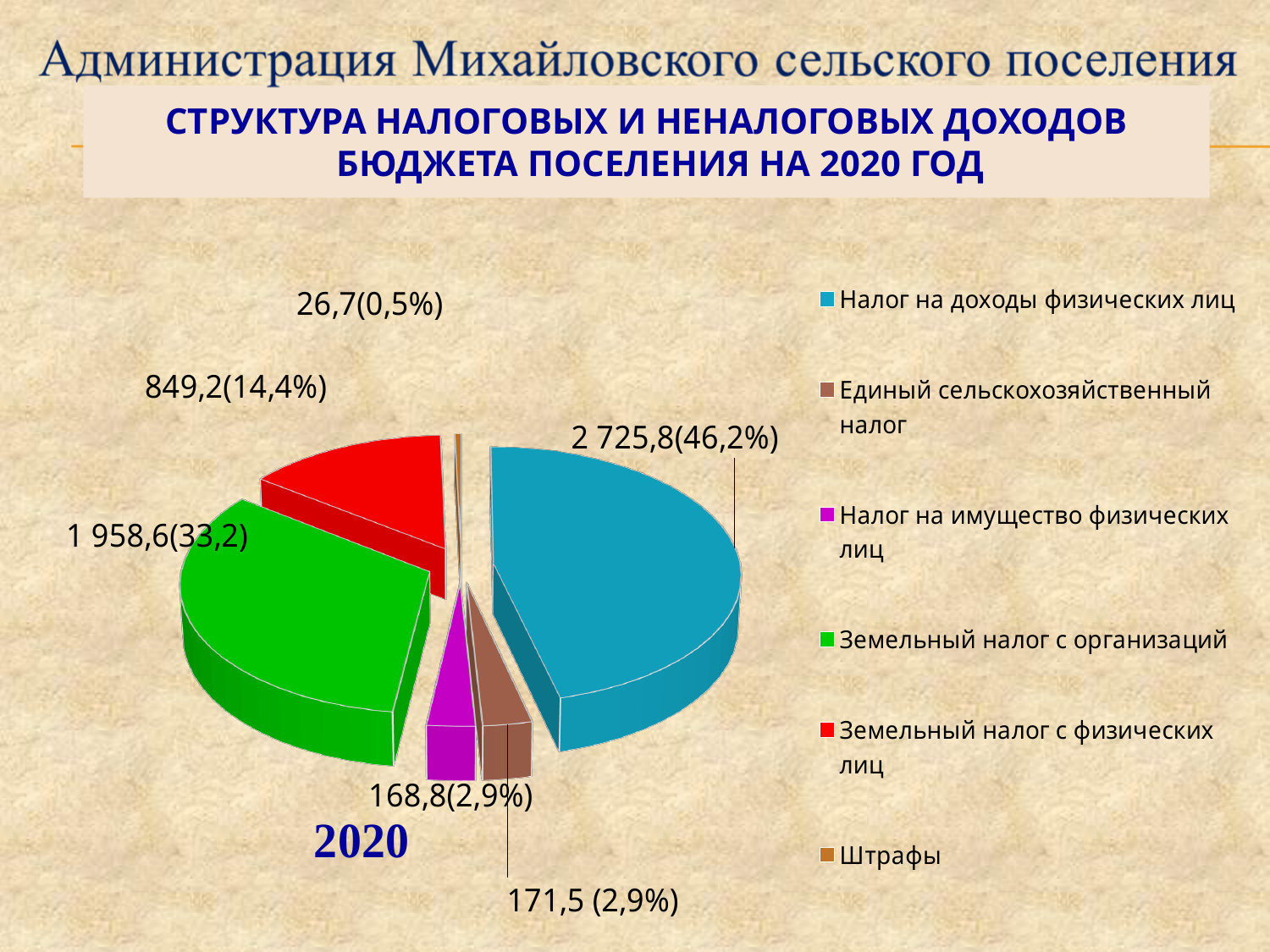
What share of the pie does Земельный налог с физических лиц have? 14,4% What value is shown for Земельный налог с организаций? 1 958,6(33,2) What value is shown for Налог на доходы физических лиц? 2 725,8(46,2%) Which category has the largest share of the pie? Налог на доходы физических лиц What value is shown for Земельный налог с физических лиц? 849,2(14,4%) What colour is the slice for Налог на доходы физических лиц? Blue What kind of chart is shown on the slide? Pie chart Which category has the smallest share of the pie? Штрафы How many categories does the legend of the pie chart list? 6 What value is shown for Налог на имущество физических лиц? 168,8(2,9%) Which is larger: Земельный налог с организаций or Земельный налог с физических лиц? Земельный налог с организаций What value is shown for Штрафы? 26,7(0,5%)